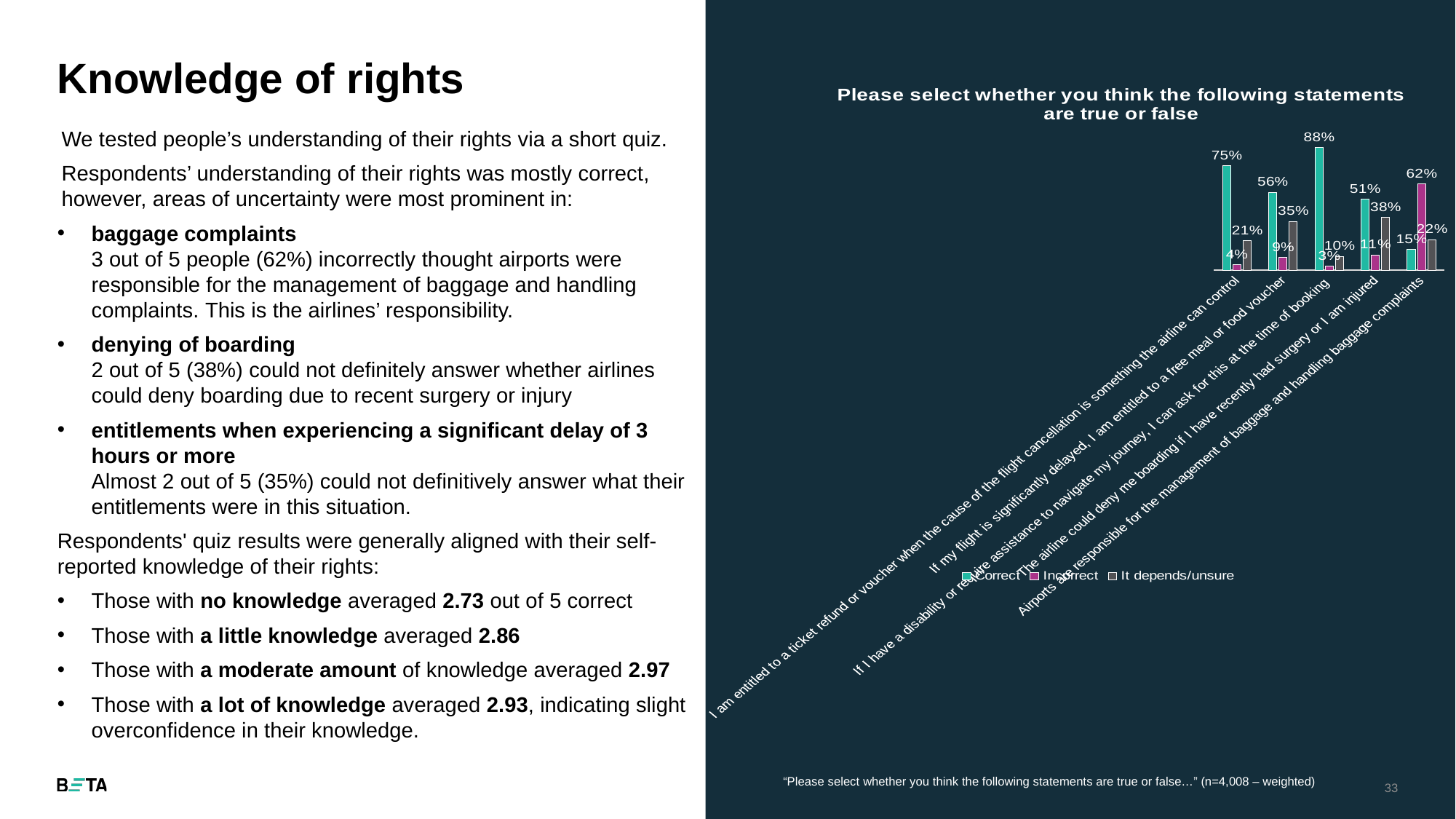
What percentage of respondents answered 'Correct' for the statement that they can ask for disability assistance at the time of booking? 88% What percentage answered 'It depends/unsure' for the statement that the airline could deny boarding after recent surgery or injury? 38% What is the 'Incorrect' percentage for the statement about being entitled to a ticket refund or voucher when the cancellation is within the airline's control? 4% Which statement has the lowest 'Correct' percentage? Airports are responsible for the management of baggage and handling complaints What is the difference between the 'Correct' percentages for the ticket refund statement (75%) and the free meal statement (56%)? 19% What type of chart is shown on the slide? bar chart For the free meal or food voucher statement, which is larger: the 'Incorrect' share or the 'It depends/unsure' share? It depends/unsure What percentage answered 'Incorrect' for the statement that airports are responsible for the management of baggage and handling complaints? 62% What is the title of the chart? Please select whether you think the following statements are true or false How many statements (categories) are plotted in the chart? 5 Which statement has the highest 'Correct' percentage? If I have a disability or require assistance to navigate my journey, I can ask for this at the time of booking How many series does the chart legend list? 3